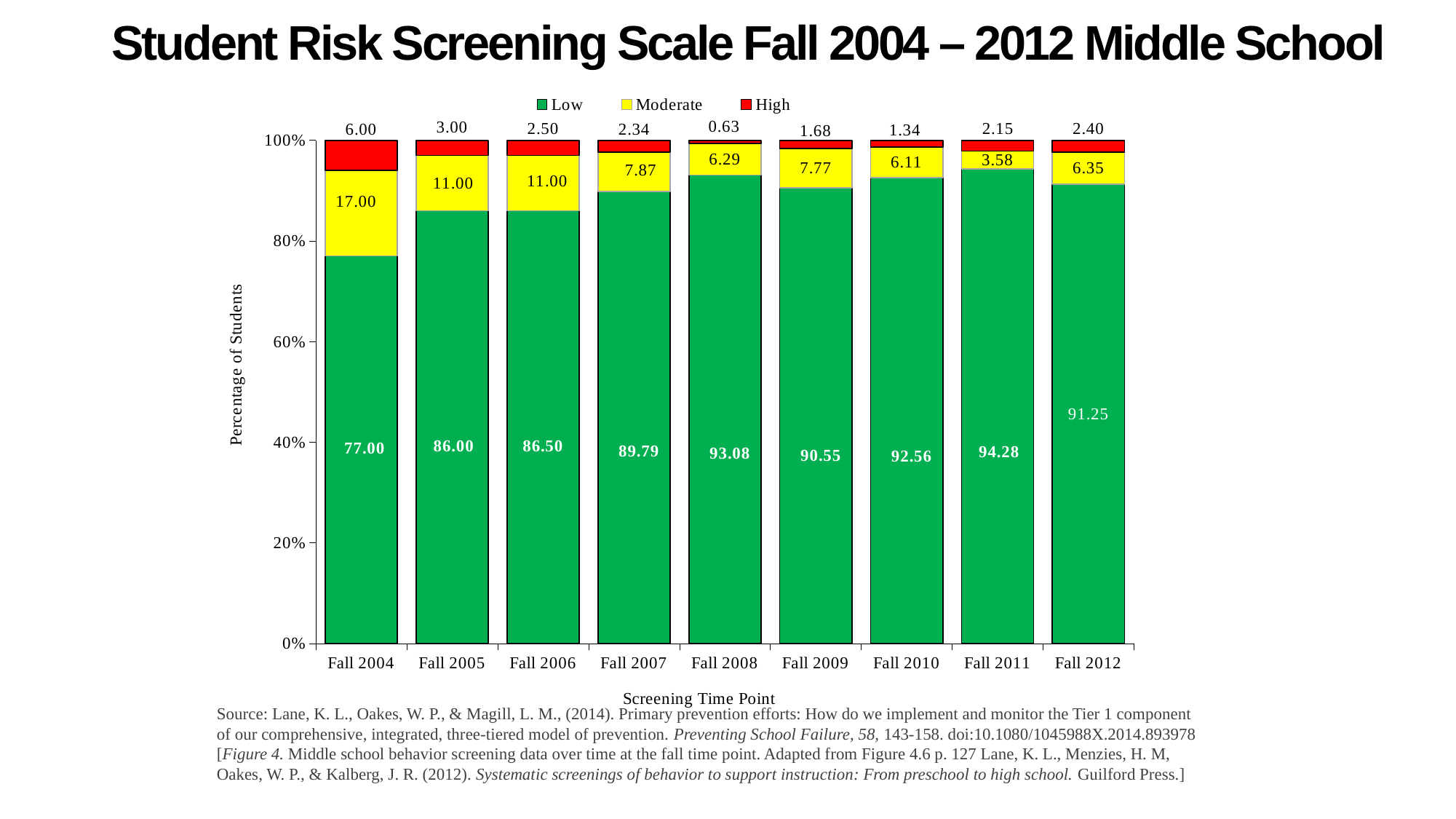
Which screening time point has the lowest High value? Fall 2008 How many screening time points are shown on the x axis? 9 What is the High value for Fall 2008? 0.63 Which is larger, the Moderate value for Fall 2007 or for Fall 2009? Fall 2007 What is the Low value for Fall 2004? 77.00 What is the Moderate value for Fall 2011? 3.58 What kind of chart is shown on the slide? Stacked bar chart What is the difference between the Low values for Fall 2005 and Fall 2004? 9.00 What is the total of the stacked bar for Fall 2004? 100.00 Which screening time point has the highest Low value? Fall 2011 What is the label of the y axis? Percentage of Students How many series does the legend list? 3